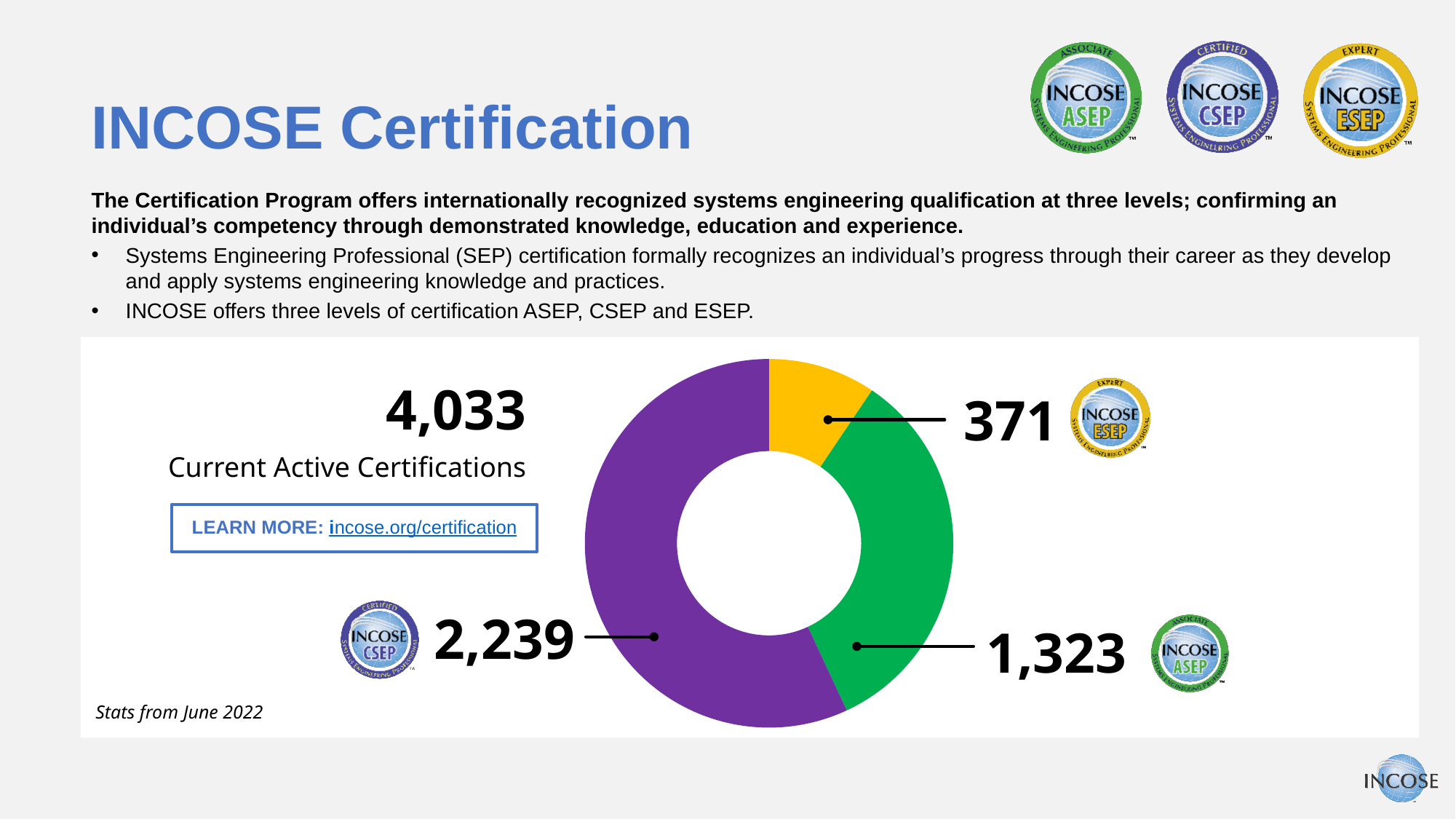
What colour is the CSEP slice of the donut chart? Purple How many current active CSEP certifications does the chart show? 2,239 How many current active ESEP certifications does the chart show? 371 What kind of chart is shown on the slide? Donut (pie) chart How many current active ASEP certifications does the chart show? 1,323 Which certification level has the smallest number of active certifications? ESEP What total number of Current Active Certifications is printed next to the chart? 4,033 What is the difference between the number of CSEP and ASEP certifications? 916 How many certification levels (slices) does the donut chart show? 3 Which has more active certifications, ASEP or ESEP? ASEP Which certification level has the largest number of active certifications? CSEP What is the difference between the number of ASEP and ESEP certifications? 952